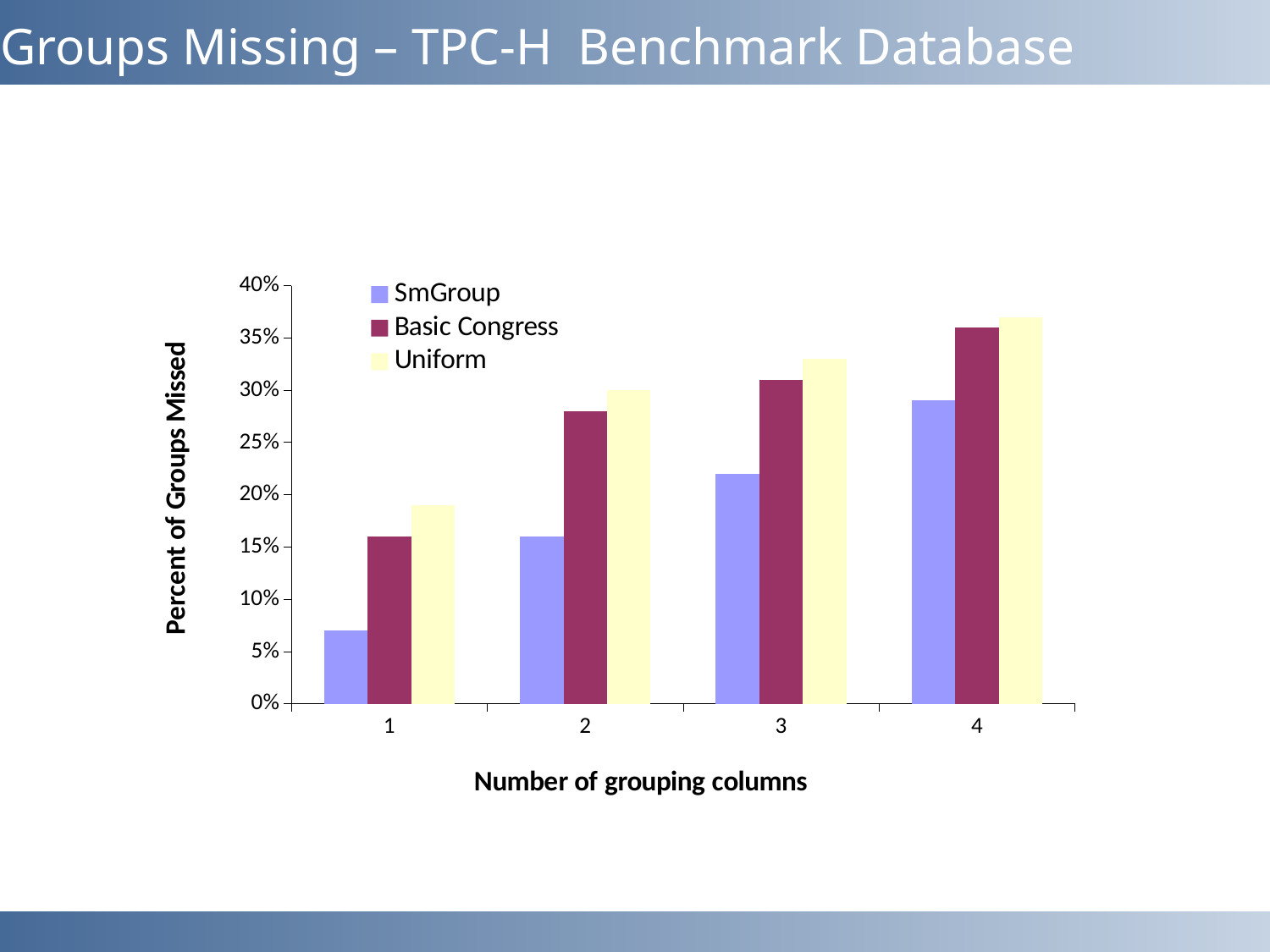
Is the Basic Congress value for 2 grouping columns greater or less than 25%? greater Is the Uniform value for 2 grouping columns greater or less than 25%? greater For 1 grouping column, which is larger: the Uniform value or the SmGroup value? Uniform For which number of grouping columns is the Uniform value lowest? 1 How many categories are shown on the x axis (Number of grouping columns)? 4 For 2 grouping columns, which is larger: the Basic Congress value or the SmGroup value? Basic Congress Do the SmGroup values rise or fall as the number of grouping columns increases? rise Is the SmGroup value for 1 grouping column greater or less than 10%? less For which number of grouping columns is the SmGroup value highest? 4 What kind of chart is shown on the slide? bar chart How many series does the legend list? 3